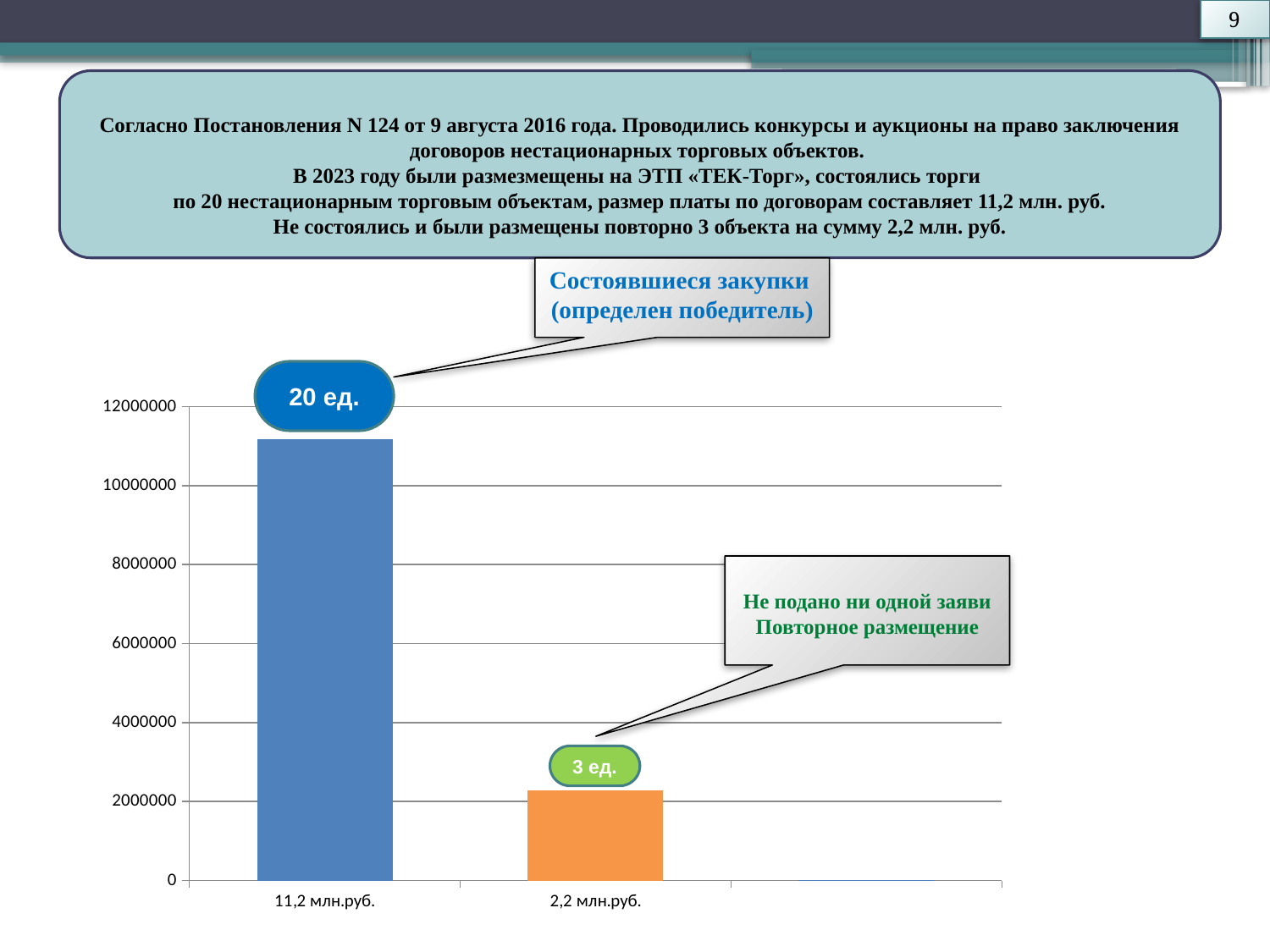
Is the value of the bar for 11,2 млн.руб. greater or less than 12000000? less What does the callout above the blue bar say? 20 ед. Is the value of the bar for 2,2 млн.руб. greater or less than 4000000? less Is the value of the bar for 11,2 млн.руб. greater or less than 10000000? greater Of the two labelled categories, which has the shorter bar? 2,2 млн.руб. Which category has the tallest bar? 11,2 млн.руб. What kind of chart is shown on the slide? bar chart What colour is the bar for 2,2 млн.руб.? orange How many category labels are shown on the x axis of the chart? 2 Which bar is taller, the one for 11,2 млн.руб. or the one for 2,2 млн.руб.? 11,2 млн.руб.